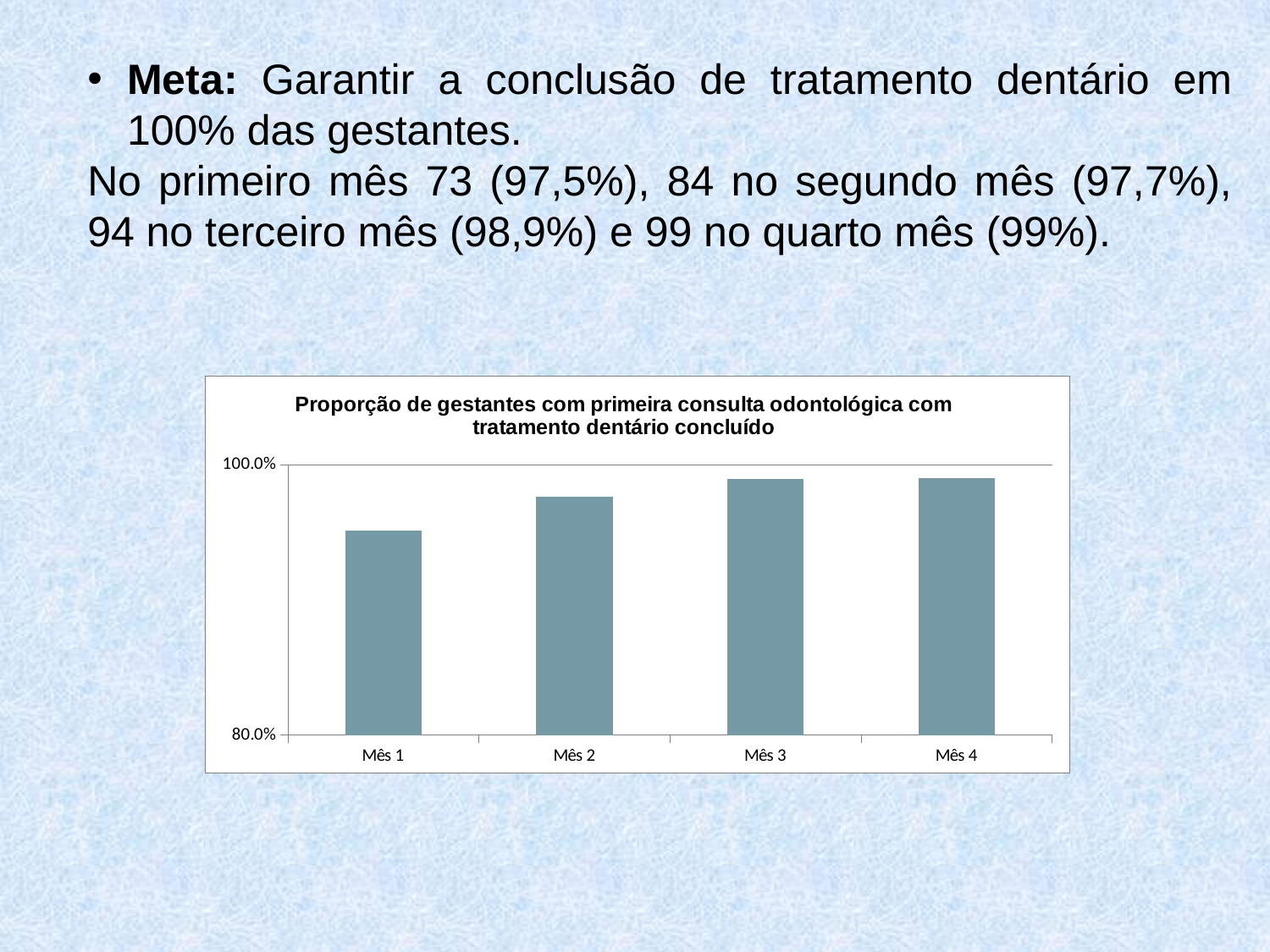
Do the values rise or fall from Mês 1 to Mês 4 in the chart? rise Is the value for Mês 4 greater or less than 100.0%? less Which month has the lowest value in the chart? Mês 1 What kind of chart is shown on the slide? bar chart What is the title of the chart? Proporção de gestantes com primeira consulta odontológica com tratamento dentário concluído How many categories (months) are shown on the x axis of the chart? 4 Which is larger in the chart, the value for Mês 2 or the value for Mês 3? Mês 3 Is the value for Mês 1 greater or less than 80.0%? greater Is the value for Mês 3 greater or less than 80.0%? greater What is the lowest value labelled on the chart's vertical axis? 80.0% Which is larger in the chart, the value for Mês 1 or the value for Mês 4? Mês 4 Which is larger in the chart, the value for Mês 1 or the value for Mês 2? Mês 2